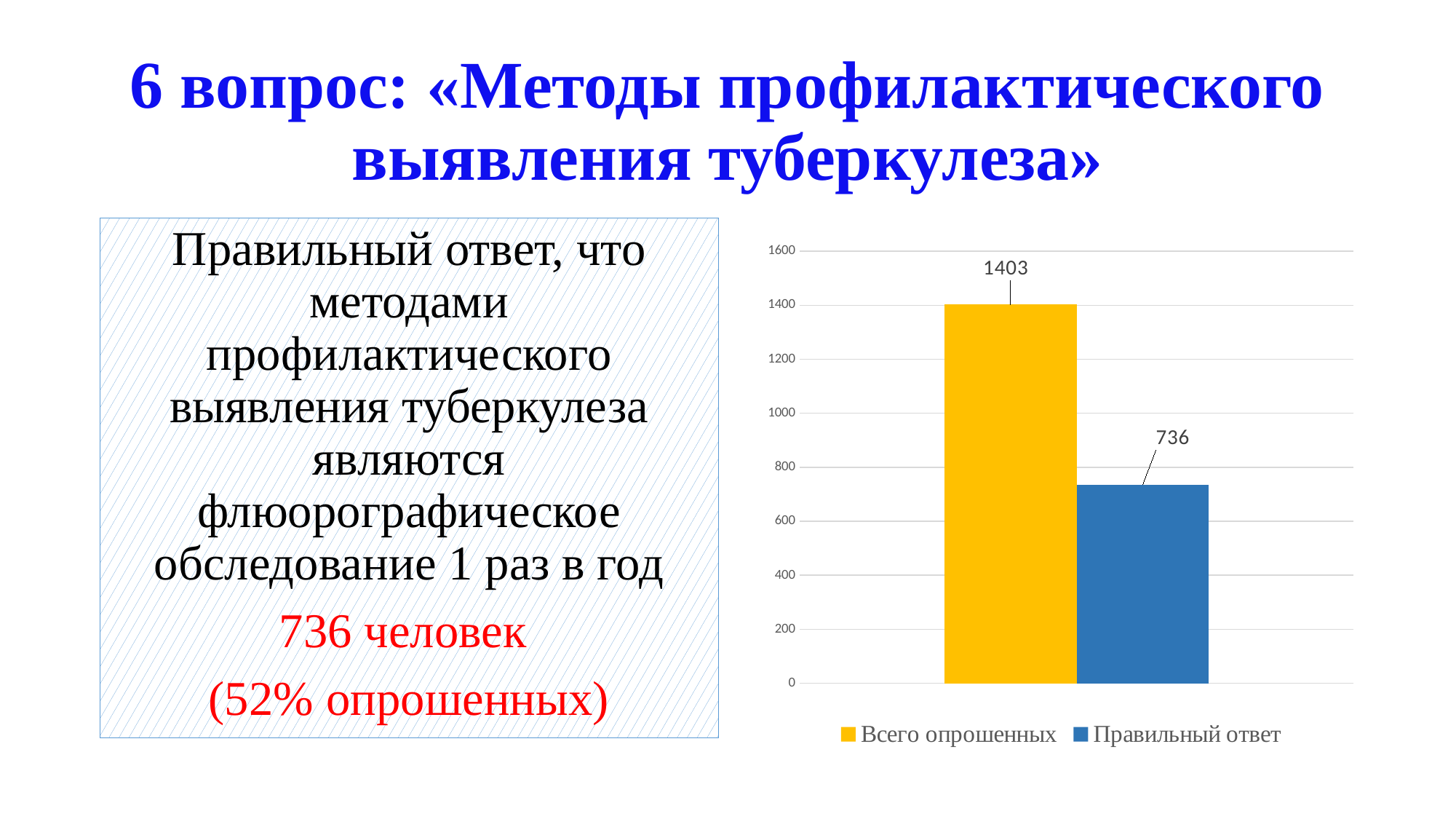
How many bars are plotted in the chart? 2 Is the value for "Правильный ответ" greater or less than 800? less How many series does the legend list? 2 What kind of chart is shown on the slide? bar chart Which is larger, "Всего опрошенных" or "Правильный ответ"? Всего опрошенных What is the difference between "Всего опрошенных" and "Правильный ответ"? 667 What colour is the bar for "Всего опрошенных"? yellow Which series has the highest value? Всего опрошенных Which series has the lowest value? Правильный ответ What is the value for "Правильный ответ"? 736 Is the value for "Всего опрошенных" greater or less than 1200? greater What is the value for "Всего опрошенных"? 1403